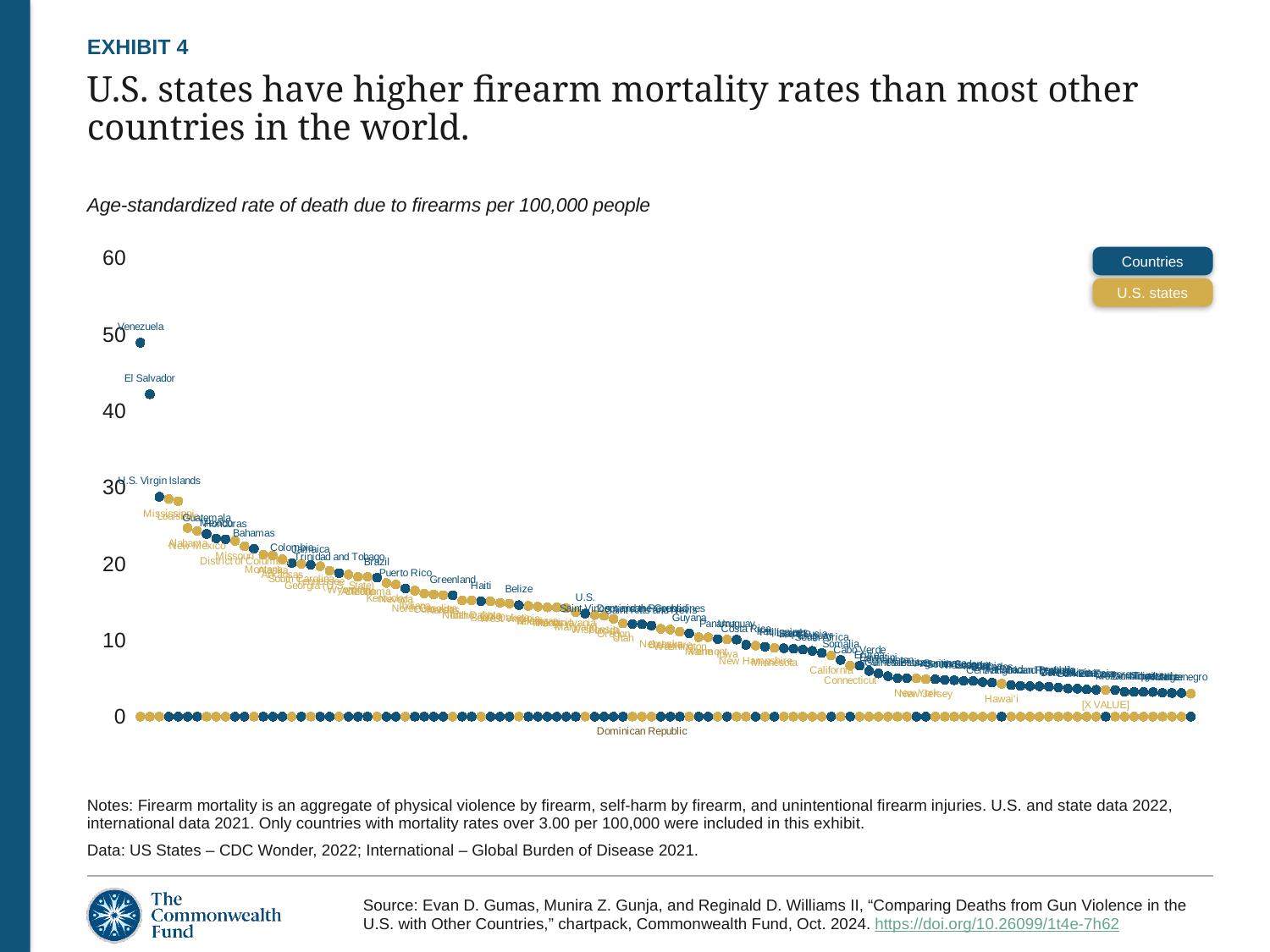
Is the value for U.S. Virgin Islands greater or less than 20? greater Is the value for Venezuela greater or less than 40? greater How many series does the legend list? 2 Which series is shown in gold/yellow dots? U.S. states Which has a higher firearm mortality rate, Mississippi or Haiti? Mississippi Is the value for El Salvador greater or less than 50? less Which country or state has the highest firearm mortality rate on the chart? Venezuela Which has a higher firearm mortality rate, Venezuela or El Salvador? Venezuela What kind of chart is shown on the slide? Scatter (dot) chart Do the plotted values rise or fall moving from left to right along the x axis? Fall What are the two series named in the legend? Countries and U.S. states